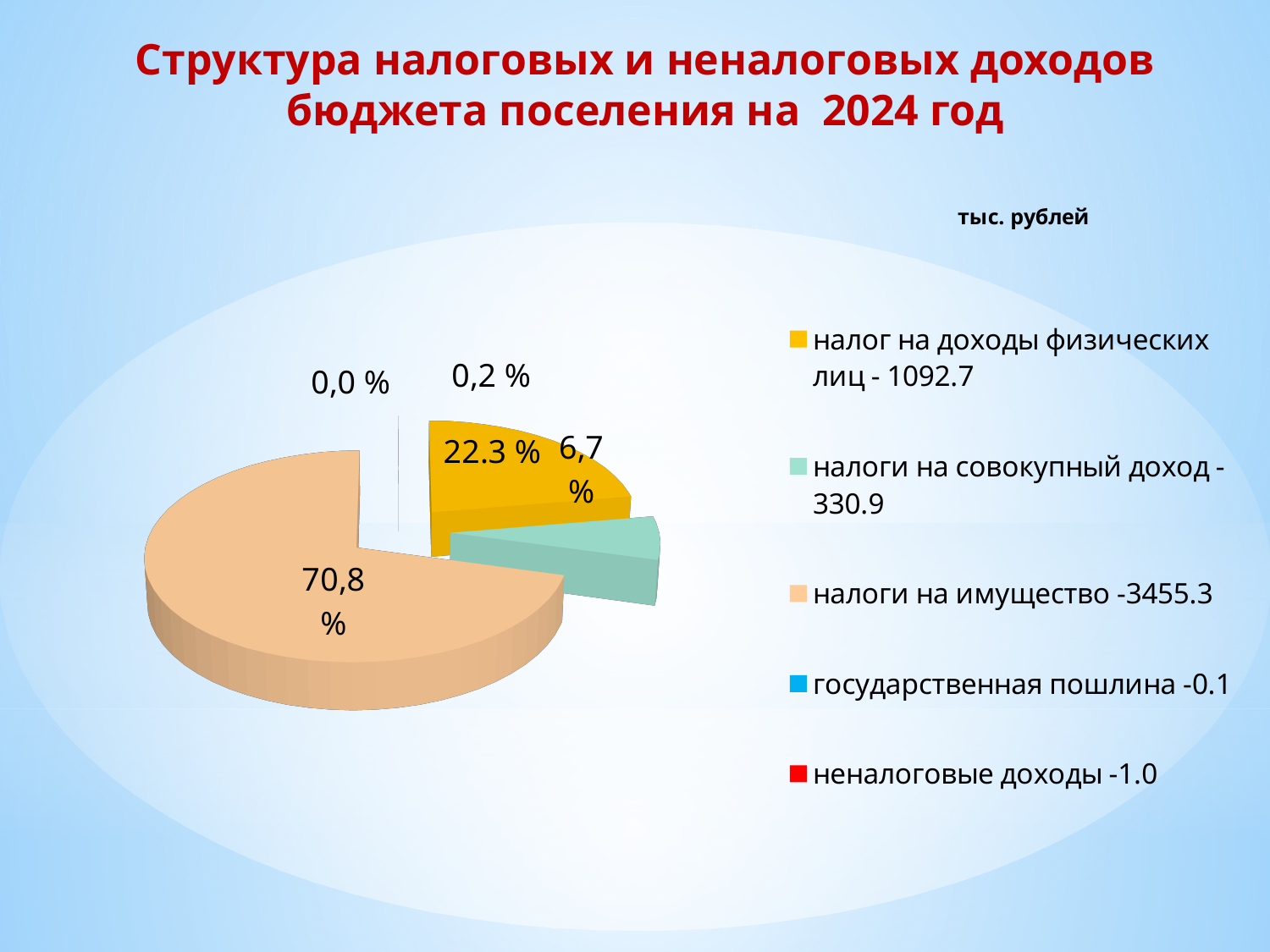
What kind of chart is shown on the slide? pie chart What value is given in the legend for налог на доходы физических лиц? 1092.7 What share of the pie does the slice for налоги на совокупный доход have? 6,7 % What value is given in the legend for налоги на имущество? 3455.3 How many entries does the legend of the pie chart list? 5 Which category has the largest slice of the pie? налоги на имущество What share of the pie does the slice for налог на доходы физических лиц have? 22.3 % What unit is stated for the values on the slide? тыс. рублей What share of the pie does the slice for налоги на имущество have? 70,8 % What value is given in the legend for налоги на совокупный доход? 330.9 What value is given in the legend for государственная пошлина? 0.1 Which is larger: the slice for налог на доходы физических лиц or the slice for налоги на совокупный доход? налог на доходы физических лиц